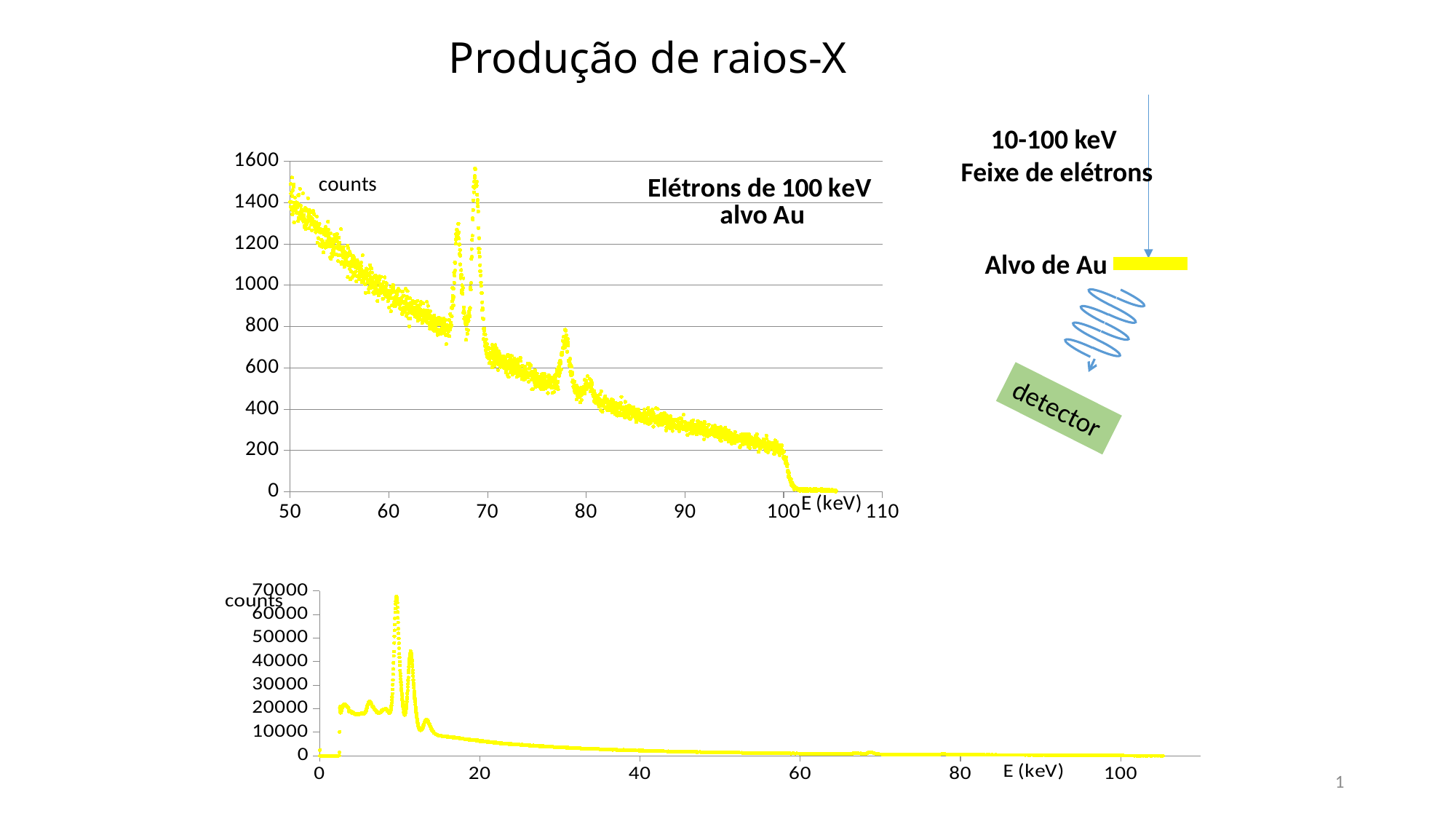
In the top chart, is the value at 105 keV greater or less than 200 counts? less In the bottom chart, do the counts rise or fall as the energy increases from 20 to 100 keV? fall In the bottom chart, is the value at 60 keV greater or less than 10000 counts? less In the top chart, is the value at 50 keV greater or less than 1200 counts? greater What kind of chart is the top chart on the slide? scatter chart What annotation describes the experimental conditions in the top chart? Elétrons de 100 keV alvo Au In the top chart, do the counts generally rise or fall as the energy increases from 50 to 100 keV? fall What kind of chart is the bottom chart on the slide? scatter chart What is the x-axis label of the top chart? E (keV)